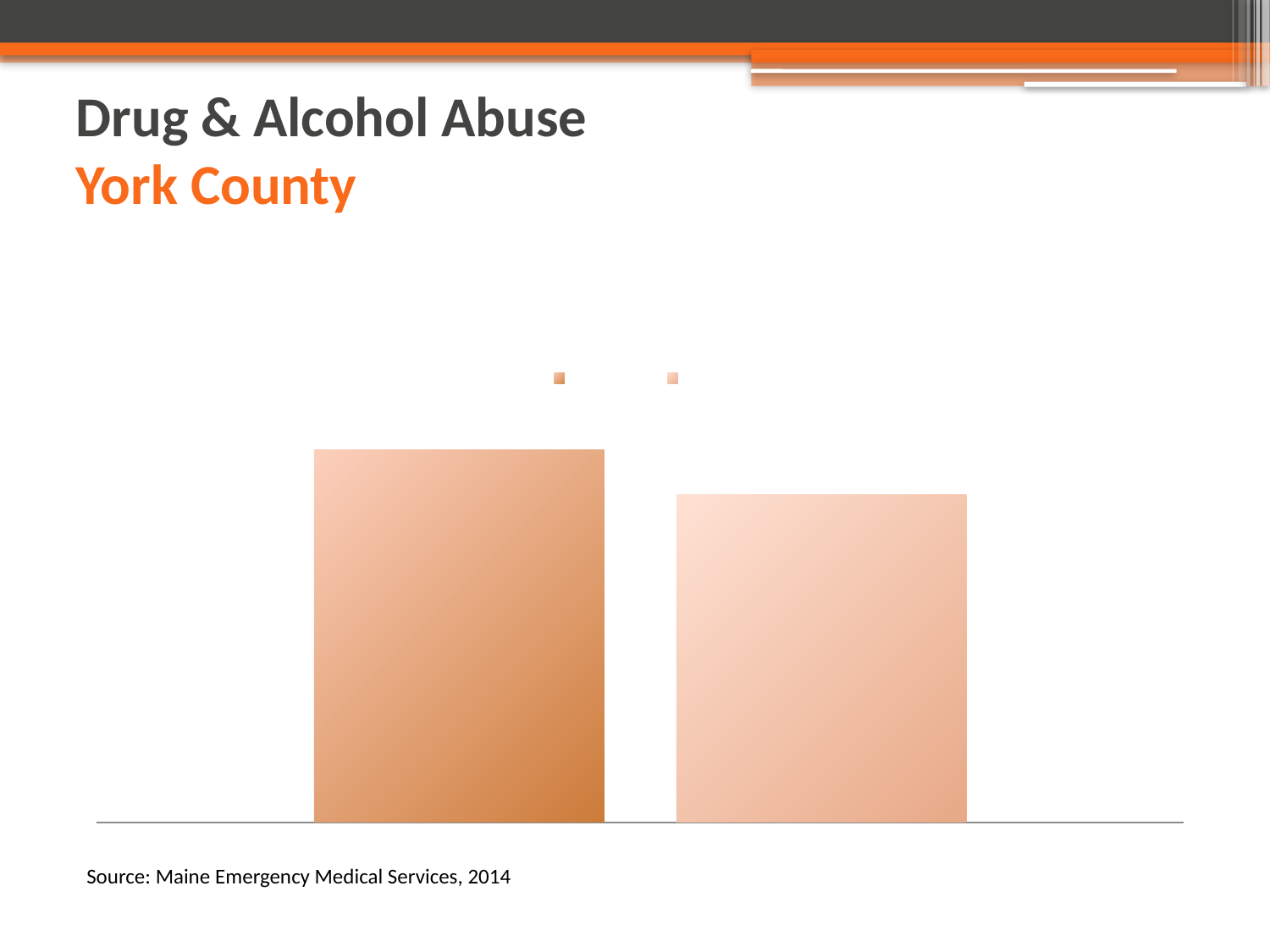
What kind of chart is shown on the slide? bar chart What source is cited below the chart? Maine Emergency Medical Services, 2014 How many bars are plotted in the chart? 2 Which bar in the chart is the tallest? the left bar Which county does the slide title say the chart is about? York County How many entries does the chart's legend show? 2 Do the bar heights rise or fall from left to right across the chart? fall Which bar in the chart is the shortest? the right bar Which bar is taller, the left bar or the right bar? the left bar